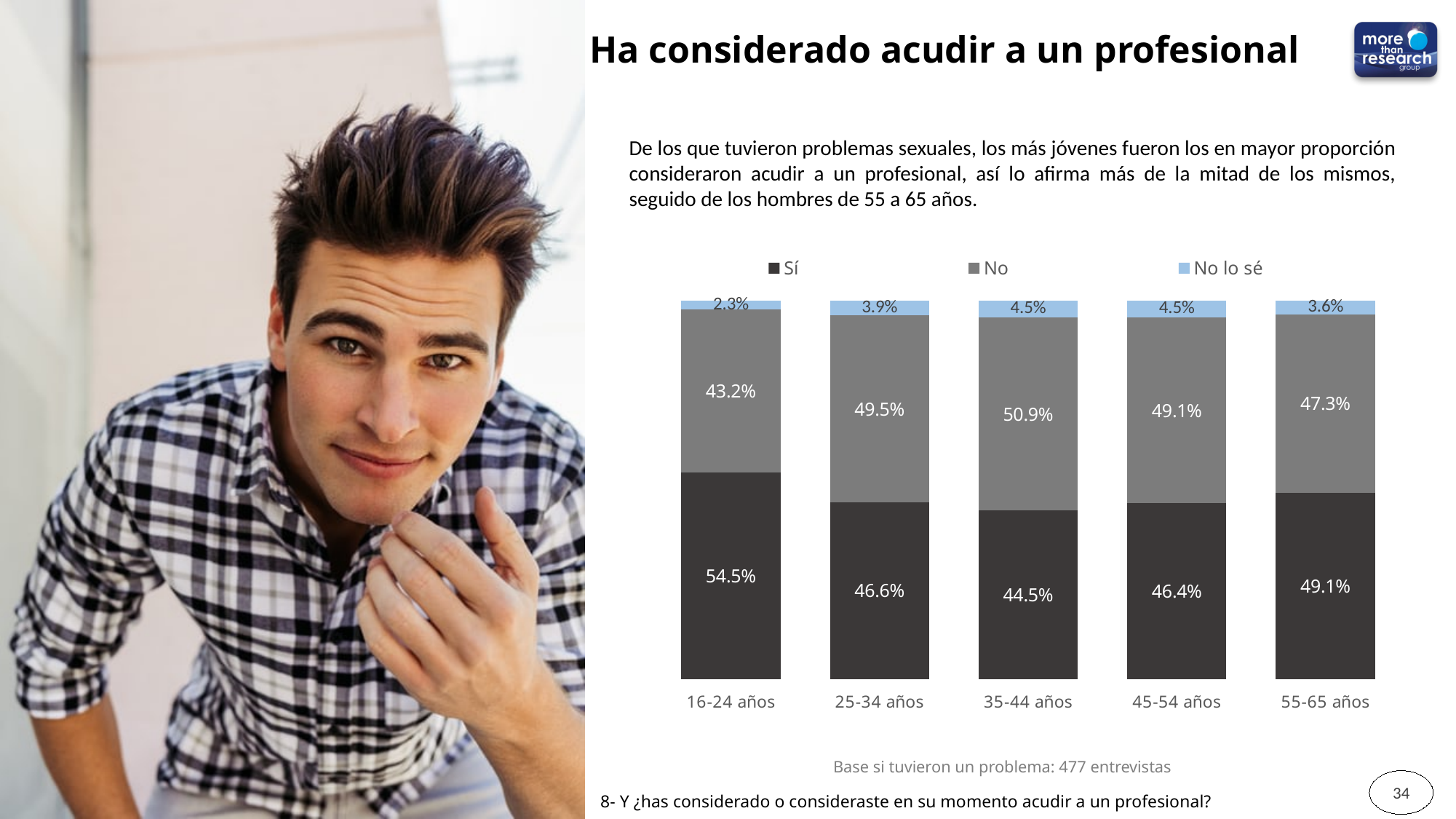
How many series does the legend list? 3 How many age groups are shown on the x axis? 5 What is the difference between the "Sí" values for 16-24 años and 25-34 años? 7.9% What is the "No" value for the 35-44 años group? 50.9% What percentage of men aged 16-24 answered "Sí"? 54.5% What kind of chart is shown on the slide? Stacked bar chart Which is larger for the 45-54 años group, the "Sí" value or the "No" value? No Which age group has the lowest "Sí" value? 35-44 años What is the "No lo sé" value for the 25-34 años group? 3.9% Which age group has the highest "Sí" value? 16-24 años What is the "Sí" value for the 55-65 años group? 49.1% Which age group has the lowest "No lo sé" value? 16-24 años